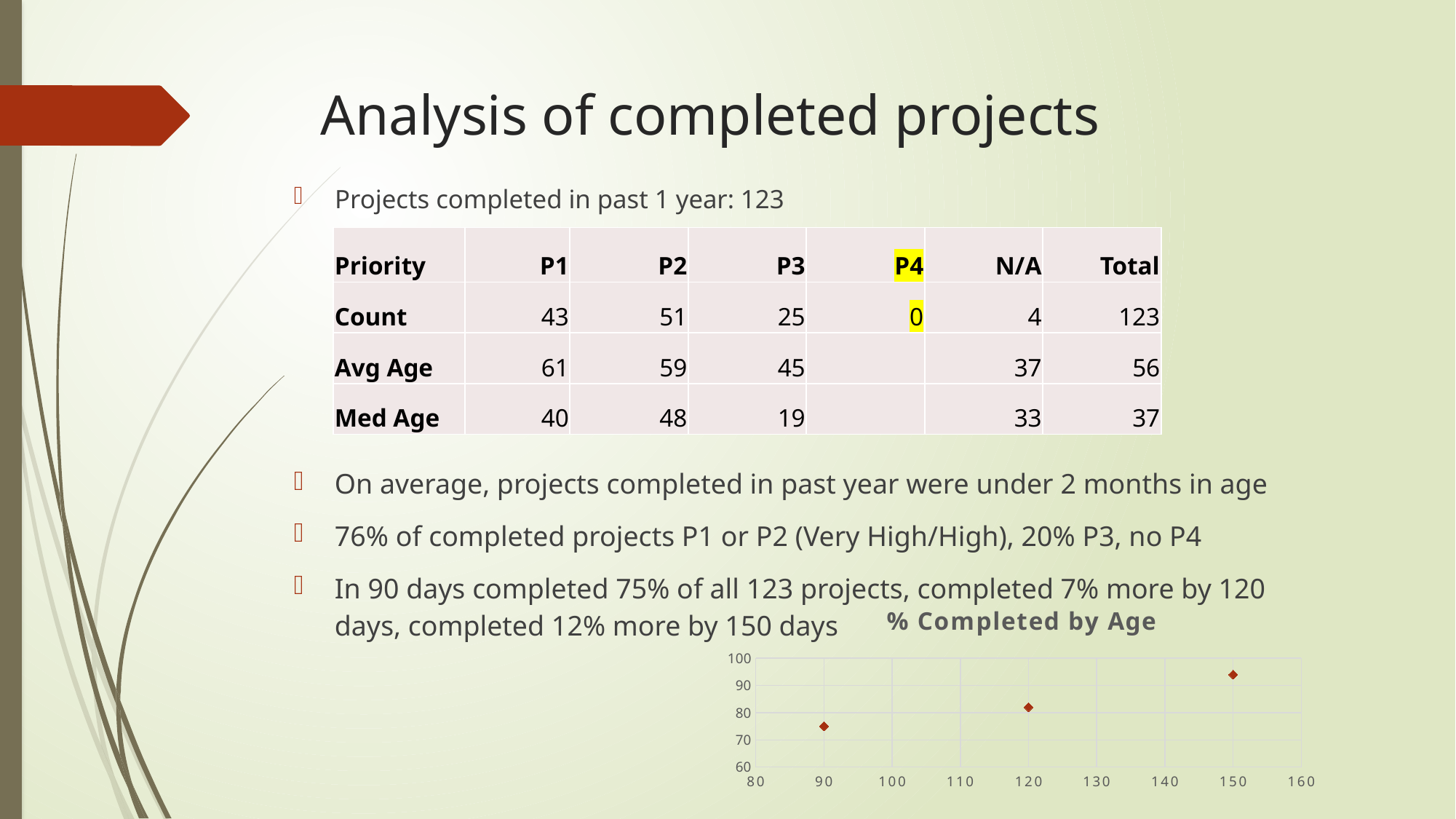
Is the value for the point at 120 greater or less than 90? less Which point has the lowest value in the chart? 90 Is the value for the point at 150 greater or less than 90? greater Which is larger, the value at 120 or the value at 90? 120 What kind of chart is shown on the slide? scatter chart What is the lowest value shown on the chart's y axis? 60 Is the value for the point at 90 greater or less than 80? less How many data points are plotted in the chart? 3 At which x-axis values are the three points plotted? 90, 120, 150 Do the plotted values rise or fall as the x axis increases? rise What is the title of the chart? % Completed by Age Which point has the highest value in the chart? 150